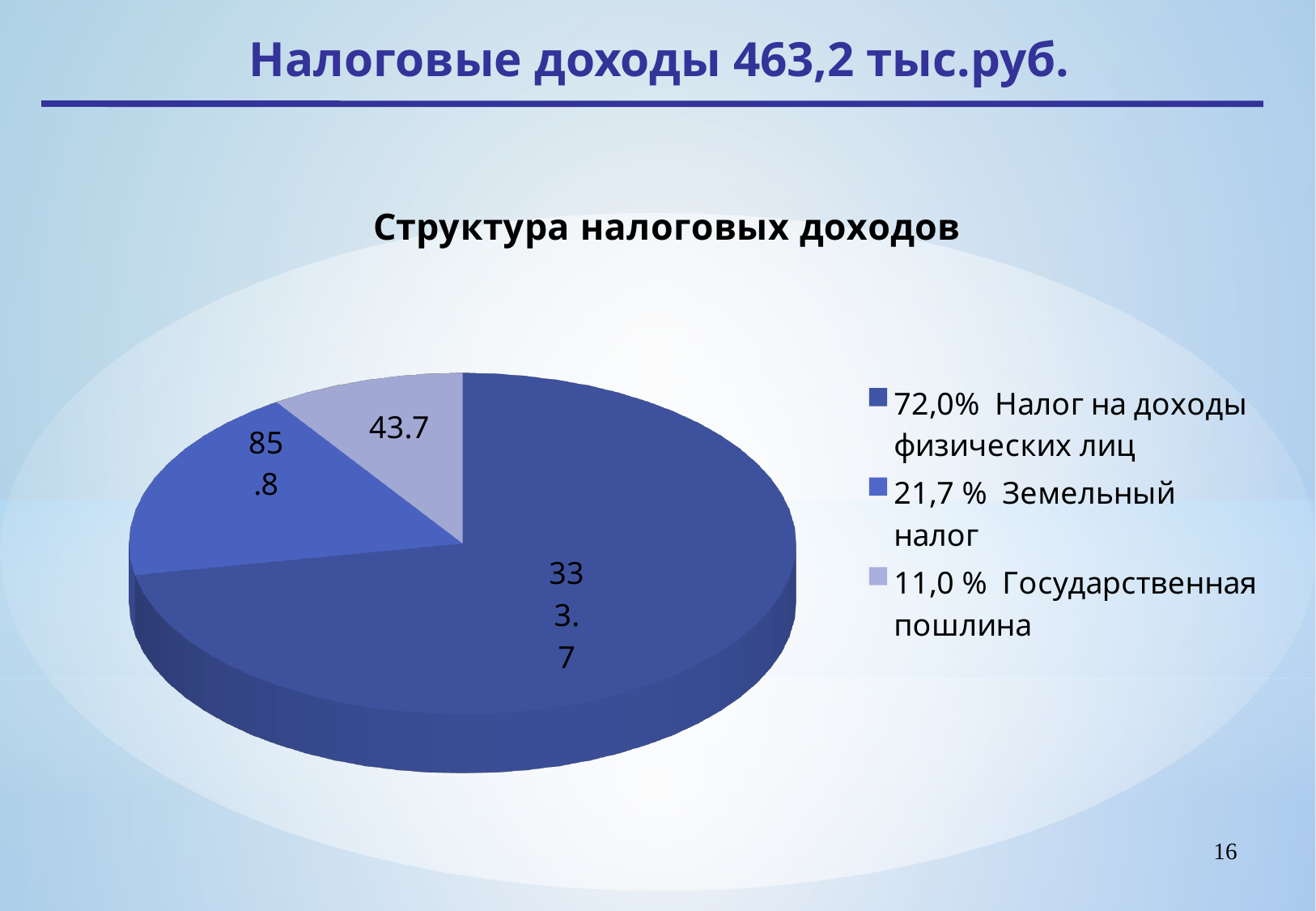
Which is larger, the value for Земельный налог or the value for Государственная пошлина? Земельный налог What type of chart is shown on the slide? Pie chart What is the value shown for Государственная пошлина? 43.7 What is the difference between the values for Земельный налог and Государственная пошлина? 42.1 What is the value shown for Земельный налог? 85.8 How many slices does the pie chart have? 3 What is the title of the chart? Структура налоговых доходов Which category has the smallest slice of the pie? Государственная пошлина How many entries does the legend list? 3 Which category has the largest slice of the pie? Налог на доходы физических лиц What is the value shown for Налог на доходы физических лиц? 333.7 What share of the pie does Земельный налог represent, according to the legend? 21,7 %